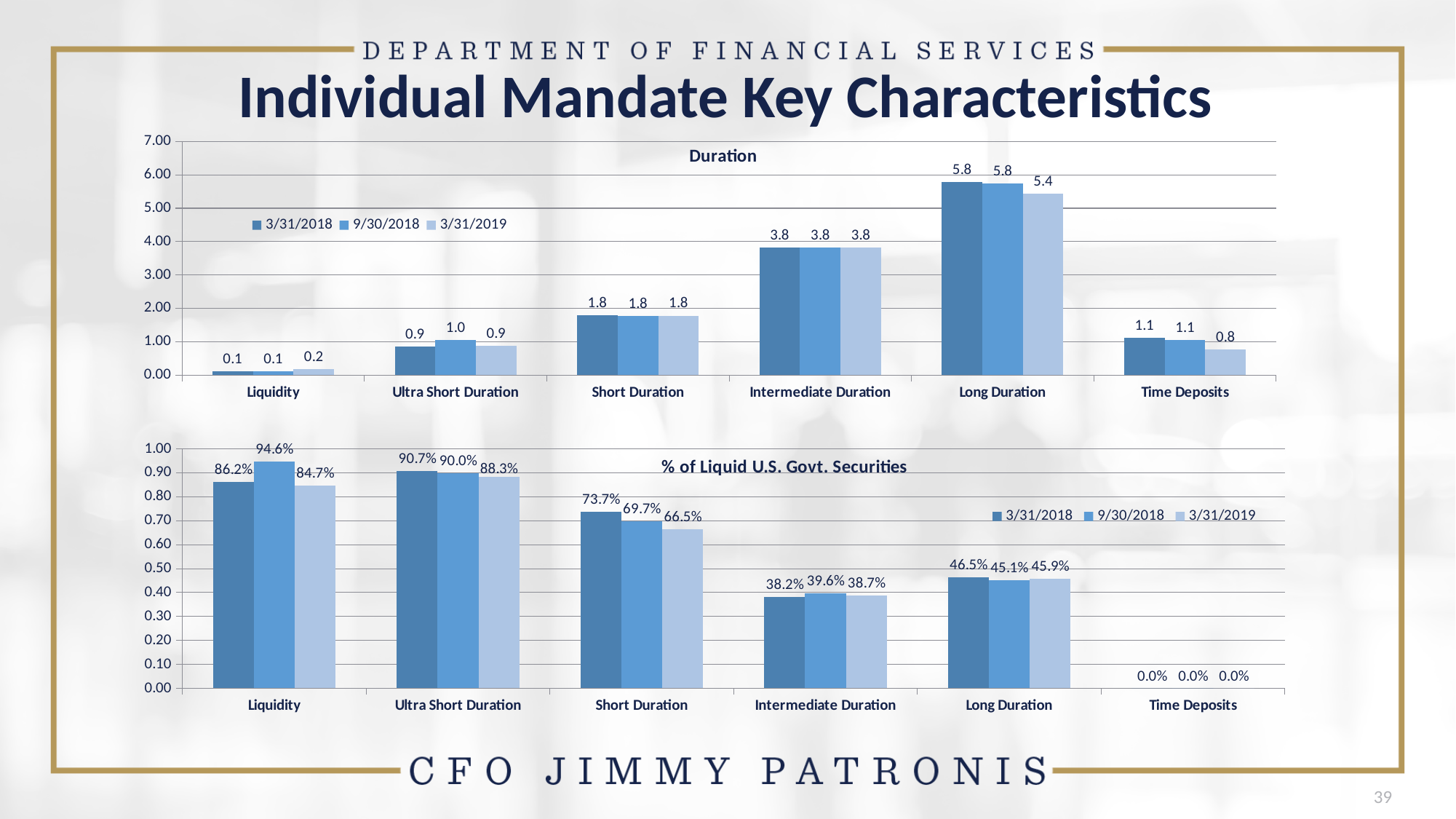
In the Duration chart, what is the difference between the Long Duration and Intermediate Duration values for 3/31/2018? 2.0 In the % of Liquid U.S. Govt. Securities chart, what is the value for Liquidity on 9/30/2018? 94.6% In the Duration chart, which category has the lowest value for 3/31/2019? Liquidity In the Duration chart, what is the value for Long Duration on 3/31/2019? 5.4 In the Duration chart, which category has the highest value for 3/31/2018? Long Duration In the % of Liquid U.S. Govt. Securities chart, which category has the lowest value for 3/31/2018? Time Deposits In the % of Liquid U.S. Govt. Securities chart, how many categories are shown on the x axis? 6 In the % of Liquid U.S. Govt. Securities chart, is the 3/31/2018 value for Short Duration larger or the 3/31/2019 value for Short Duration? 3/31/2018 In the Duration chart, how many series does the legend list? 3 In the % of Liquid U.S. Govt. Securities chart, what is the value for Short Duration on 3/31/2019? 66.5% What kind of chart is the Duration chart? Bar chart In the Duration chart, what is the value for Ultra Short Duration on 9/30/2018? 1.0